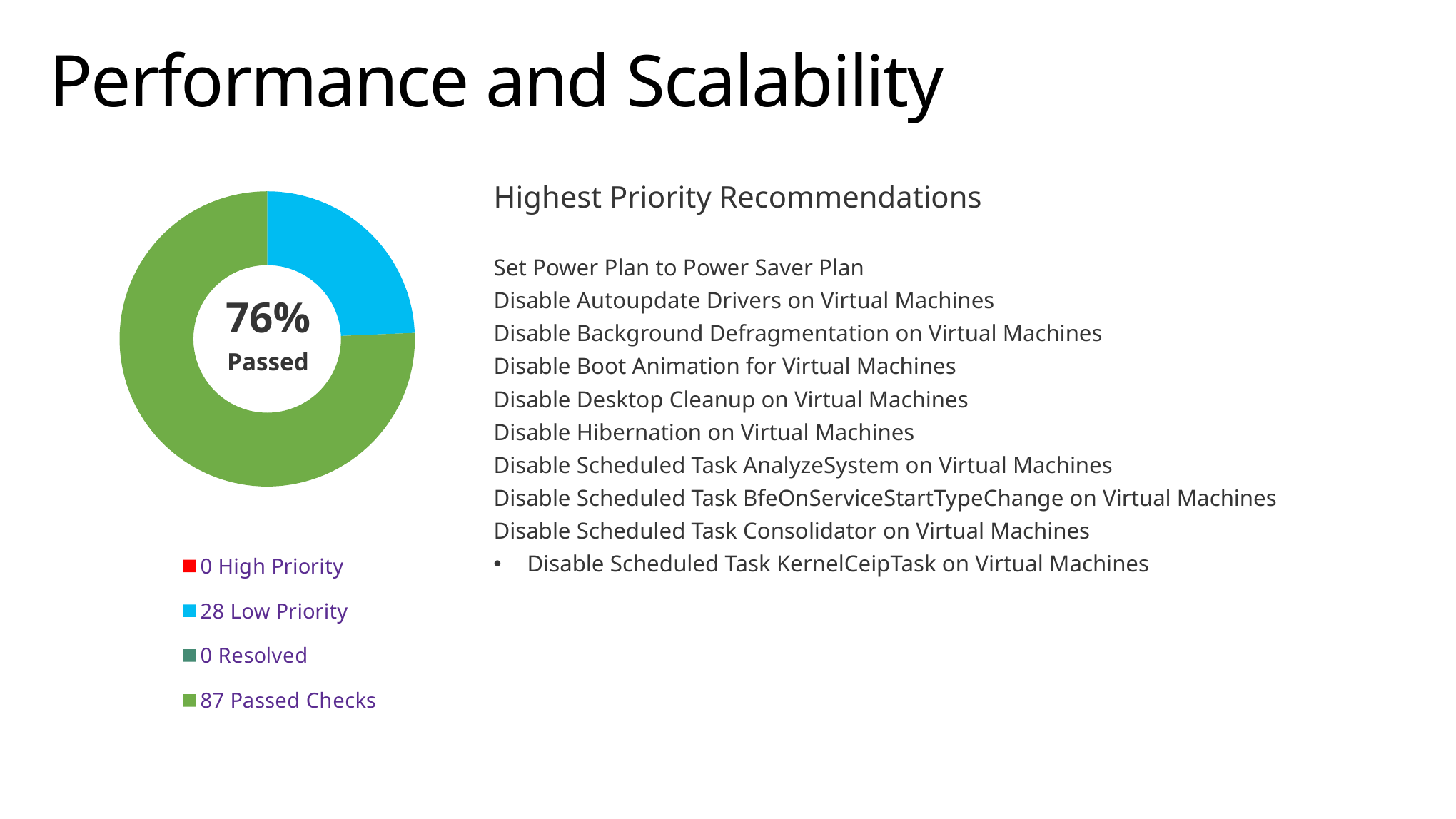
How many Low Priority items does the legend show? 28 How many High Priority items does the legend show? 0 What colour represents Low Priority in the chart? Blue How many Resolved items does the legend show? 0 Which category has the largest value in the chart? Passed Checks What is the difference between Passed Checks and Low Priority? 59 How many categories does the legend list? 4 What is the total of all categories in the legend? 115 How many Passed Checks does the legend show? 87 Which is larger, Low Priority or Passed Checks? Passed Checks What percentage is shown in the centre of the doughnut chart? 76% What kind of chart is shown on the slide? Doughnut chart